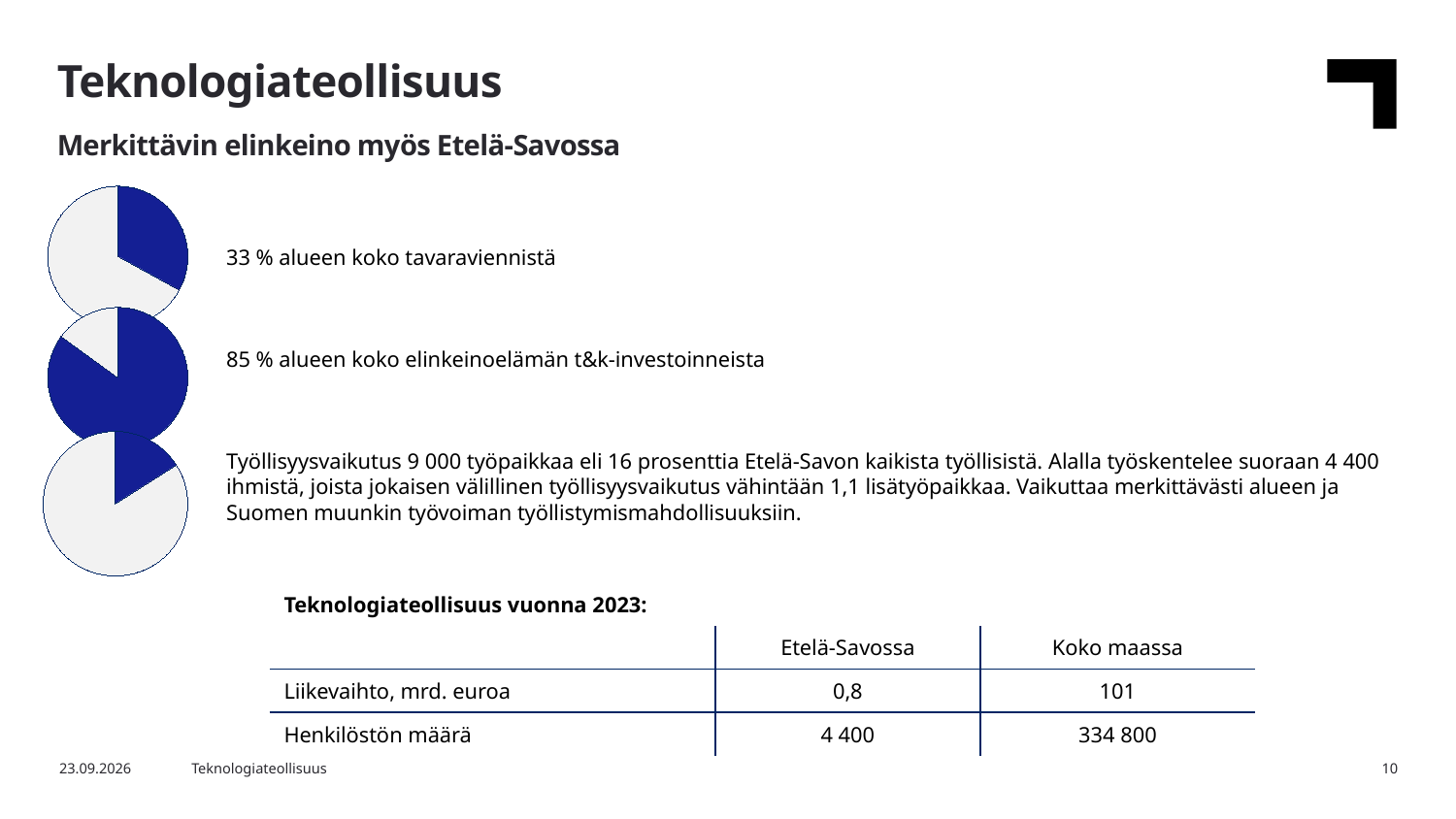
In the bottom pie chart (työllisyysvaikutus), what share of Etelä-Savo's employed does the blue slice represent? 16 prosenttia How many pie charts are on the slide? 3 In the top pie chart (tavaravienti), what share does the blue slice represent? 33 % What kind of charts are shown on the left side of the slide? Pie charts What colour is used for the highlighted slice in each pie chart? Dark blue Which of the three pie charts has the largest blue slice? The middle one (85 % of t&k-investoinnit) In the middle pie chart (t&k-investoinnit), what share does the blue slice represent? 85 % Which of the three pie charts has the smallest blue slice? The bottom one (16 % of työlliset) In the top pie chart, is the blue slice greater or less than 50 %? less What does the top pie chart's blue slice represent according to the text next to it? Alueen koko tavaravienti (33 %) In the middle pie chart, is the blue slice greater or less than 50 %? greater Is the blue slice larger in the top pie chart or in the bottom pie chart? Top pie chart